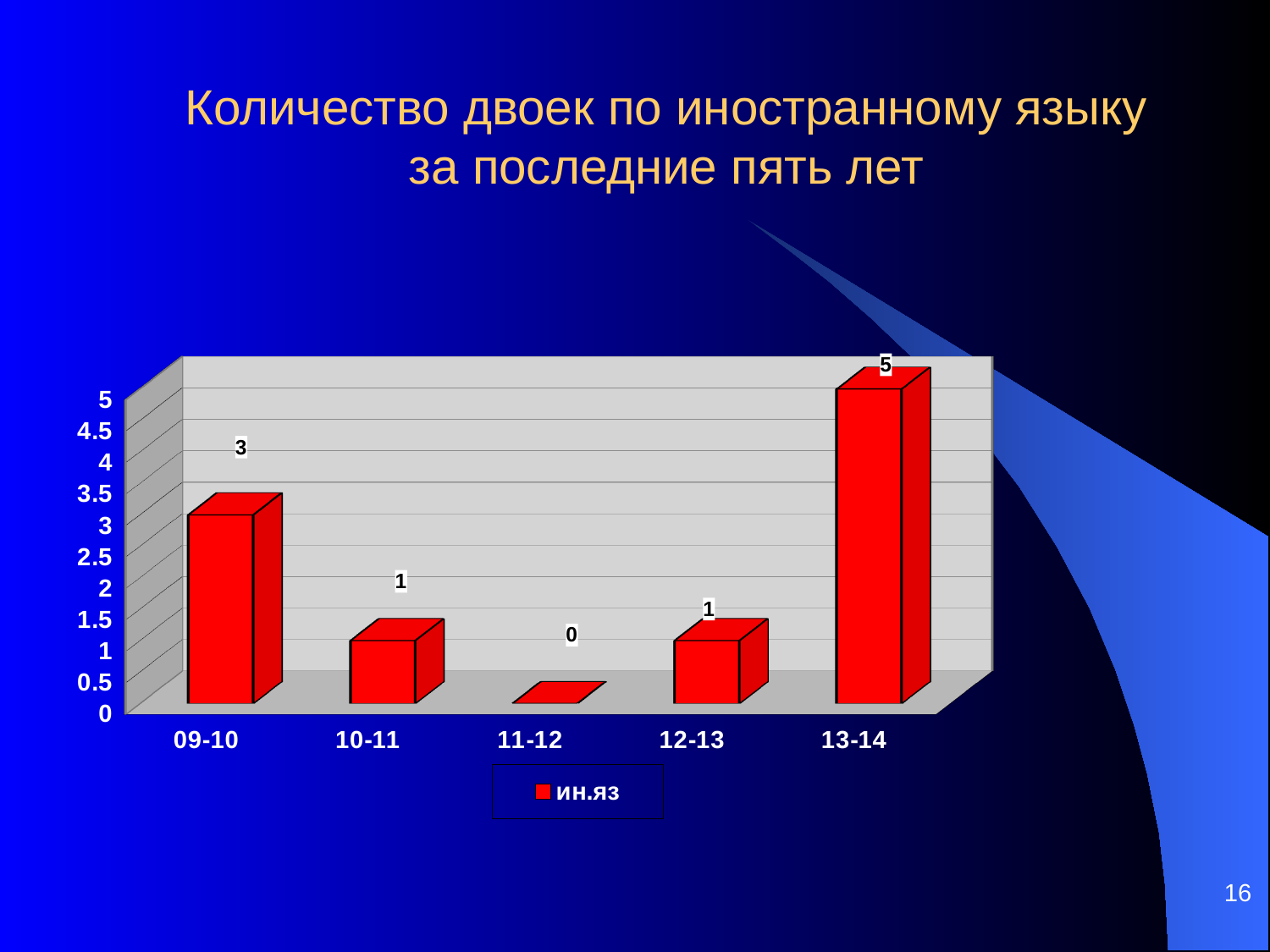
Which category has the highest value? 13-14 What colour are the bars? red How many series does the legend list? 1 What is the difference between the values for 13-14 and 09-10? 2 What is the value for 13-14? 5 Which is larger, the value for 09-10 or the value for 12-13? 09-10 What is the value for 09-10? 3 What is the name of the series in the legend? ин.яз How many categories are shown on the x axis? 5 What is the value for 11-12? 0 Which category has the lowest value? 11-12 What kind of chart is shown? bar chart